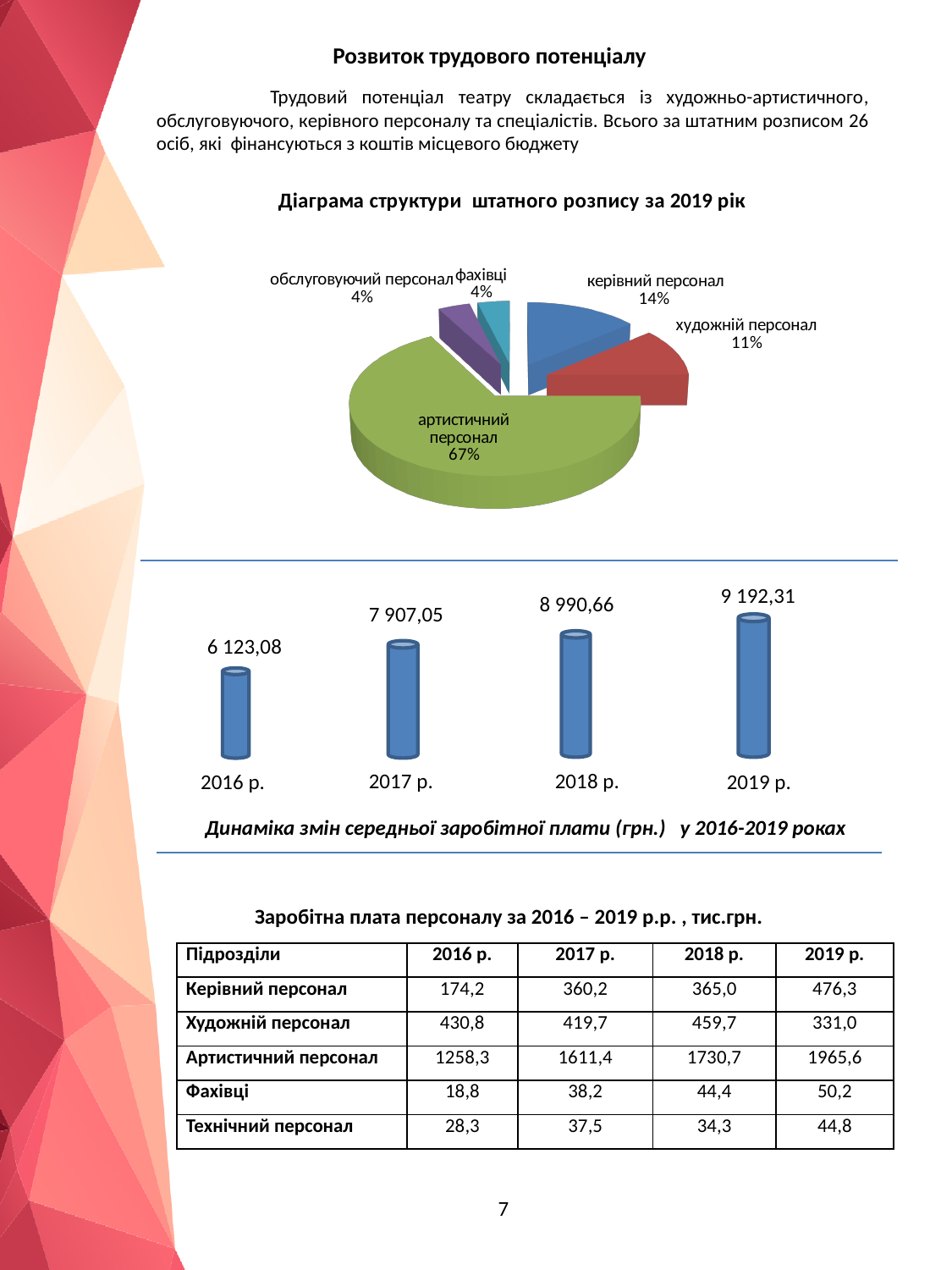
In the chart 'Динаміка змін середньої заробітної плати (грн.) у 2016-2019 роках', what is the value for 2016 р.? 6 123,08 What kind of chart is 'Динаміка змін середньої заробітної плати (грн.) у 2016-2019 роках'? bar chart In the pie chart 'Діаграма структури штатного розпису за 2019 рік', which is larger: 'керівний персонал' or 'художній персонал'? керівний персонал In the chart 'Динаміка змін середньої заробітної плати (грн.) у 2016-2019 роках', do the values rise or fall from 2016 р. to 2019 р.? rise In the pie chart 'Діаграма структури штатного розпису за 2019 рік', what share does 'художній персонал' have? 11% In the pie chart 'Діаграма структури штатного розпису за 2019 рік', what share does 'артистичний персонал' have? 67% In the chart 'Динаміка змін середньої заробітної плати (грн.) у 2016-2019 роках', what is the value for 2019 р.? 9 192,31 In the pie chart 'Діаграма структури штатного розпису за 2019 рік', what share does 'керівний персонал' have? 14% In the pie chart 'Діаграма структури штатного розпису за 2019 рік', how many slices are there? 5 In the chart 'Динаміка змін середньої заробітної плати (грн.) у 2016-2019 роках', what is the difference between the 2019 р. and 2016 р. values? 3 069,23 In the pie chart 'Діаграма структури штатного розпису за 2019 рік', which category has the largest slice? артистичний персонал In the chart 'Динаміка змін середньої заробітної плати (грн.) у 2016-2019 роках', which year has the lowest value? 2016 р.